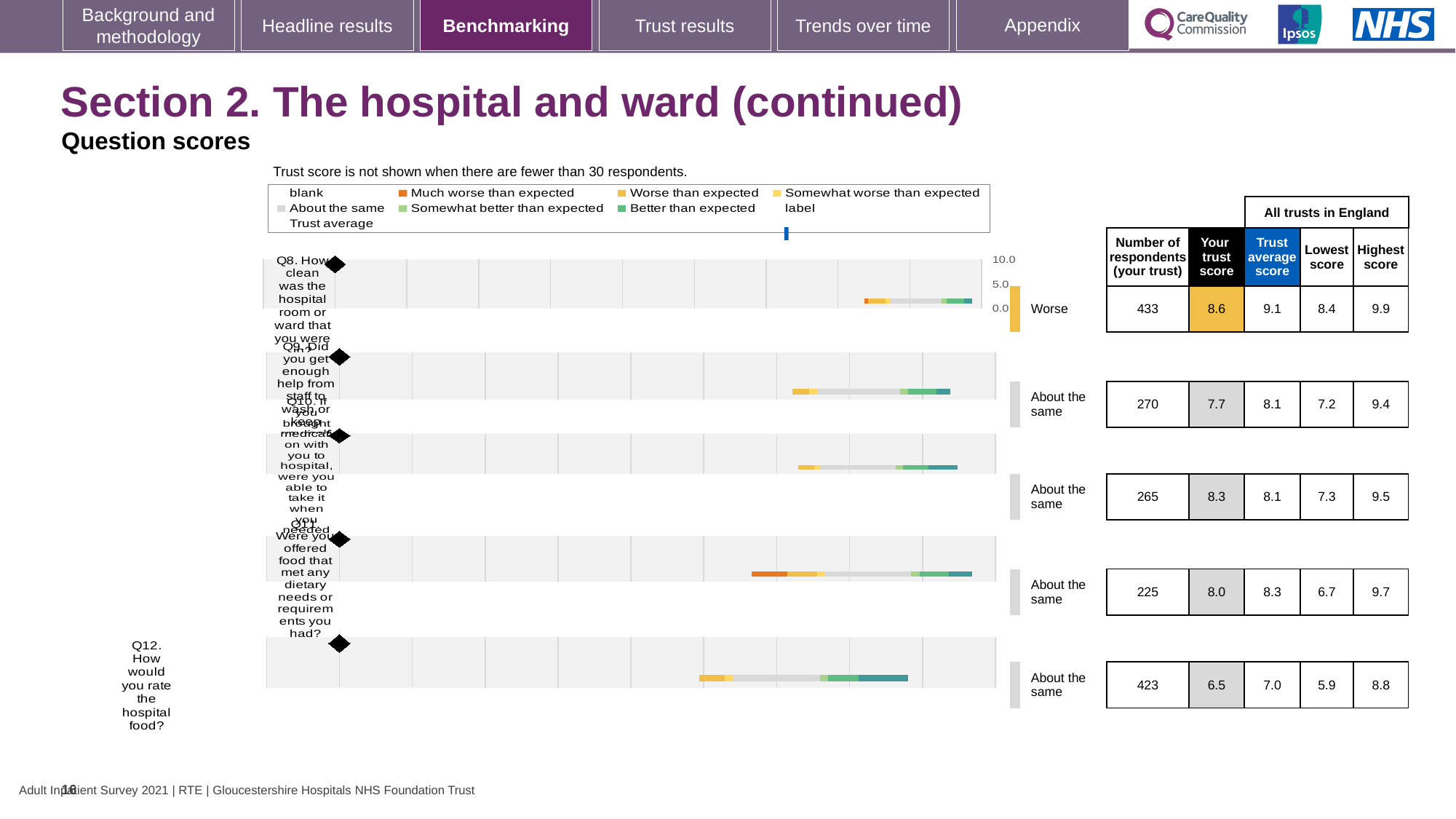
How many respondents from your trust answered Q8? 433 Which question has the lowest 'Your trust score'? Q12 What is the difference between the trust average score and your trust score for Q8? 0.5 What kind of chart is used to show the question scores on this slide? bar chart Which question has the highest 'Your trust score'? Q8 For Q10, which is larger: your trust score or the trust average score? Your trust score Which question is the only one rated 'Worse' rather than 'About the same'? Q8 What is the lowest score across all trusts in England for Q11 (dietary needs)? 6.7 What is the difference between the highest and lowest score across all trusts in England for Q12? 2.9 How many questions (categories) are plotted in the question scores chart? 5 What is the trust average score for Q12 (How would you rate the hospital food)? 7.0 What is the 'Your trust score' for Q8 (How clean was the hospital room or ward)? 8.6